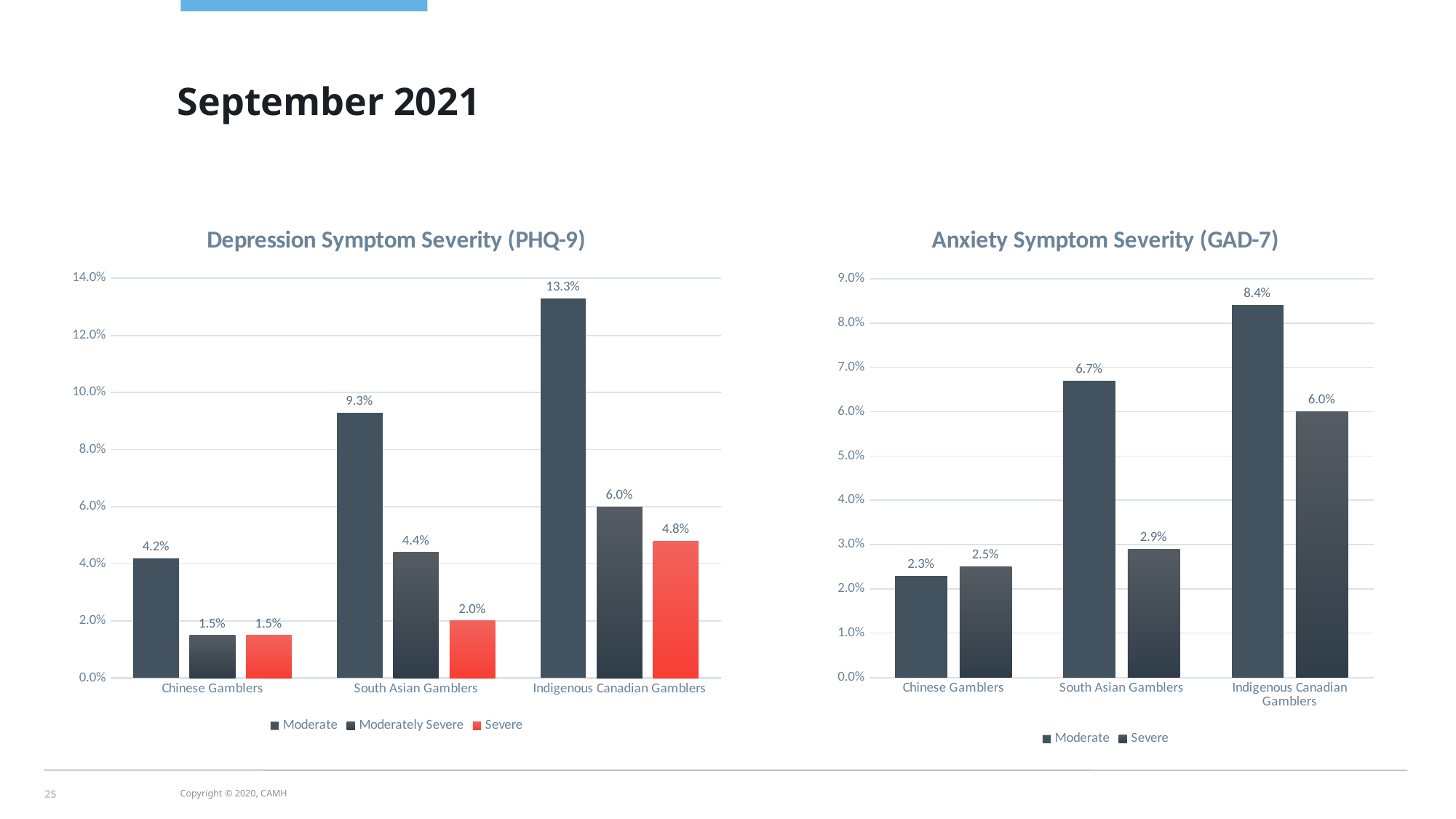
In the Depression Symptom Severity (PHQ-9) chart, what is the Moderate value for Indigenous Canadian Gamblers? 13.3% In the Depression Symptom Severity (PHQ-9) chart, what is the difference between the Moderate values for Indigenous Canadian Gamblers and South Asian Gamblers? 4.0% In the Anxiety Symptom Severity (GAD-7) chart, what is the Severe value for Indigenous Canadian Gamblers? 6.0% How many series does the legend of the Depression Symptom Severity (PHQ-9) chart list? 3 In the Depression Symptom Severity (PHQ-9) chart, which group has the lowest Moderate value? Chinese Gamblers In the Depression Symptom Severity (PHQ-9) chart, what colour are the Severe bars? Red In the Depression Symptom Severity (PHQ-9) chart, what is the Severe value for South Asian Gamblers? 2.0% In the Anxiety Symptom Severity (GAD-7) chart, which is larger for Chinese Gamblers: the Moderate value or the Severe value? Severe In the Anxiety Symptom Severity (GAD-7) chart, what is the difference between the Moderate and Severe values for South Asian Gamblers? 3.8% In the Anxiety Symptom Severity (GAD-7) chart, which group has the highest Moderate value? Indigenous Canadian Gamblers How many groups are shown on the x axis of the Depression Symptom Severity (PHQ-9) chart? 3 What kind of chart is the Anxiety Symptom Severity (GAD-7) chart? Bar chart